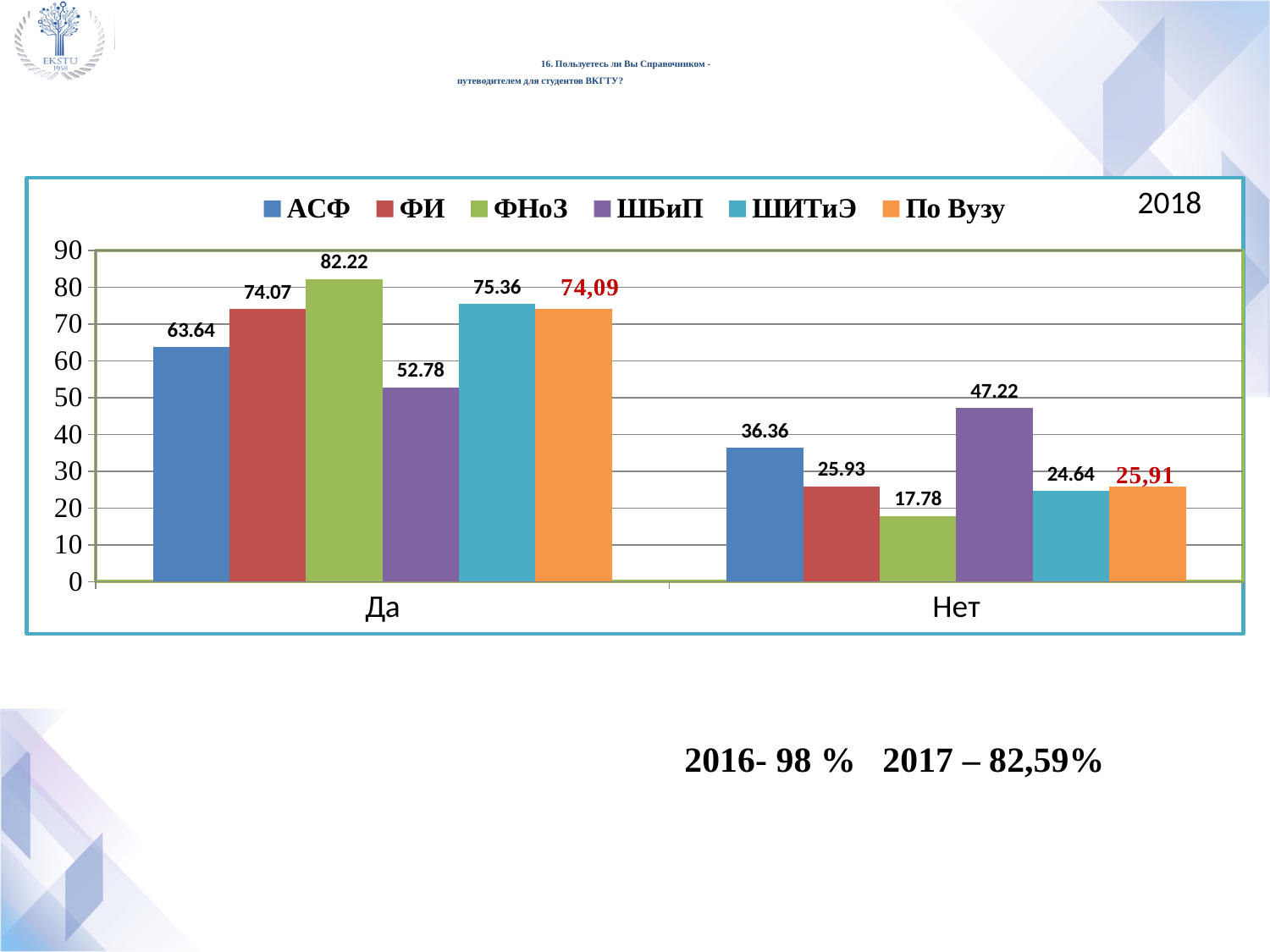
What is the value for АСФ in the Нет category? 36.36 How many categories are shown on the x axis? 2 Which series has the lowest value in the Нет category? ФНоЗ Which series has the highest value in the Да category? ФНоЗ How many series does the legend list? 6 What is the value for По Вузу in the Да category? 74,09 What is the difference between the ФНоЗ and ШБиП values in the Да category? 29.44 What kind of chart is shown on the slide? bar chart What is the value for ФНоЗ in the Да category? 82.22 What is the value for ШБиП in the Нет category? 47.22 Which is larger in the Нет category: the value for ФИ or the value for ШИТиЭ? ФИ Is the value for ШБиП in the Да category greater or less than 60? less